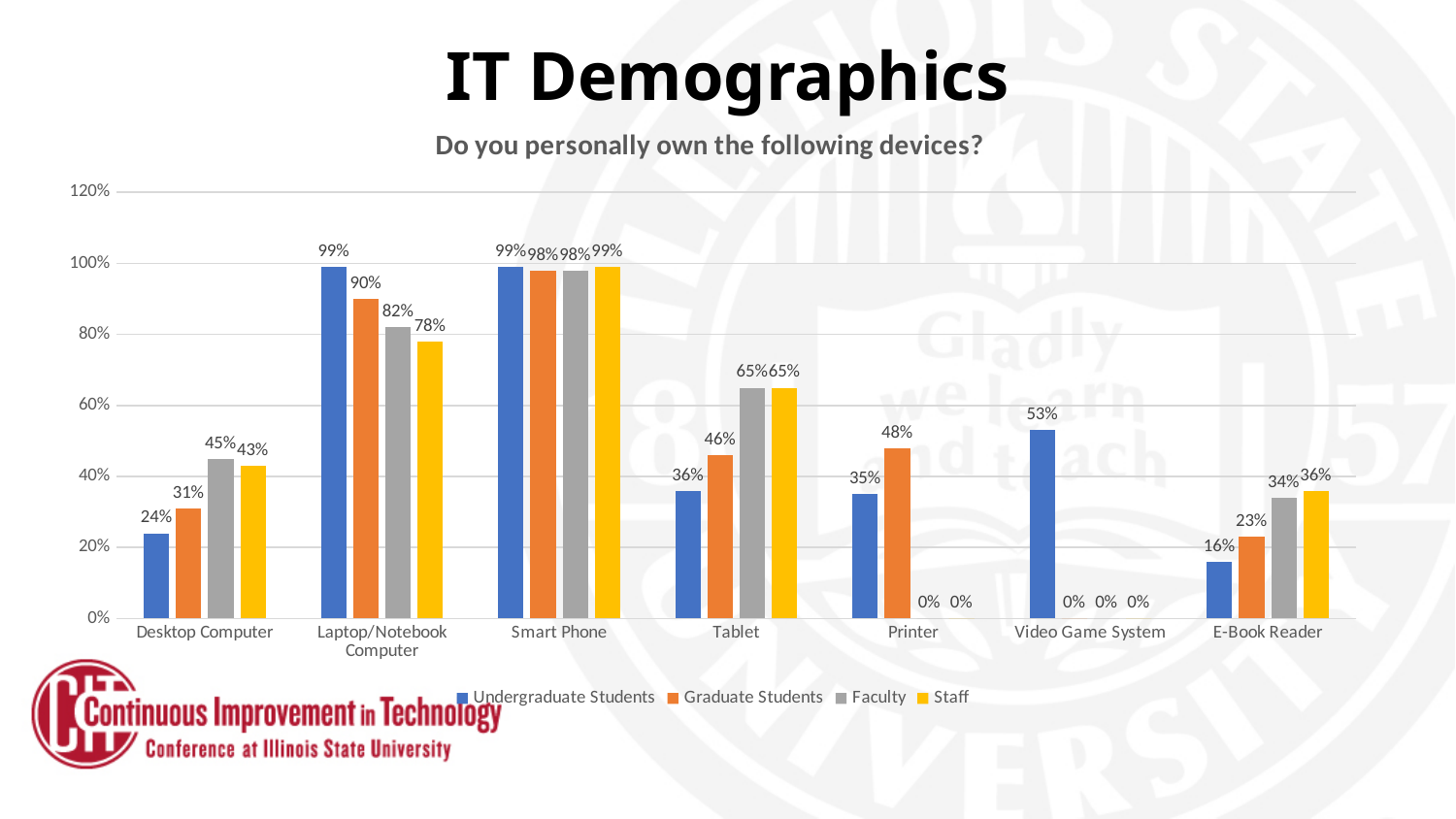
Which is larger: Faculty ownership of a Desktop Computer or Staff ownership of a Desktop Computer? Faculty What percentage of Staff own an E-Book Reader? 36% Which group has the lowest ownership of an E-Book Reader? Undergraduate Students How many series does the legend list? 4 Which group has the highest ownership of a Laptop/Notebook Computer? Undergraduate Students What kind of chart is shown on the slide? Bar chart What percentage of Undergraduate Students own a Desktop Computer? 24% What percentage of Faculty own a Tablet? 65% How many device categories are shown on the x axis? 7 What is the difference between Graduate Students and Undergraduate Students for Laptop/Notebook Computer ownership? 9% What is the subtitle (question) shown above the chart? Do you personally own the following devices? What percentage of Graduate Students own a Printer? 48%